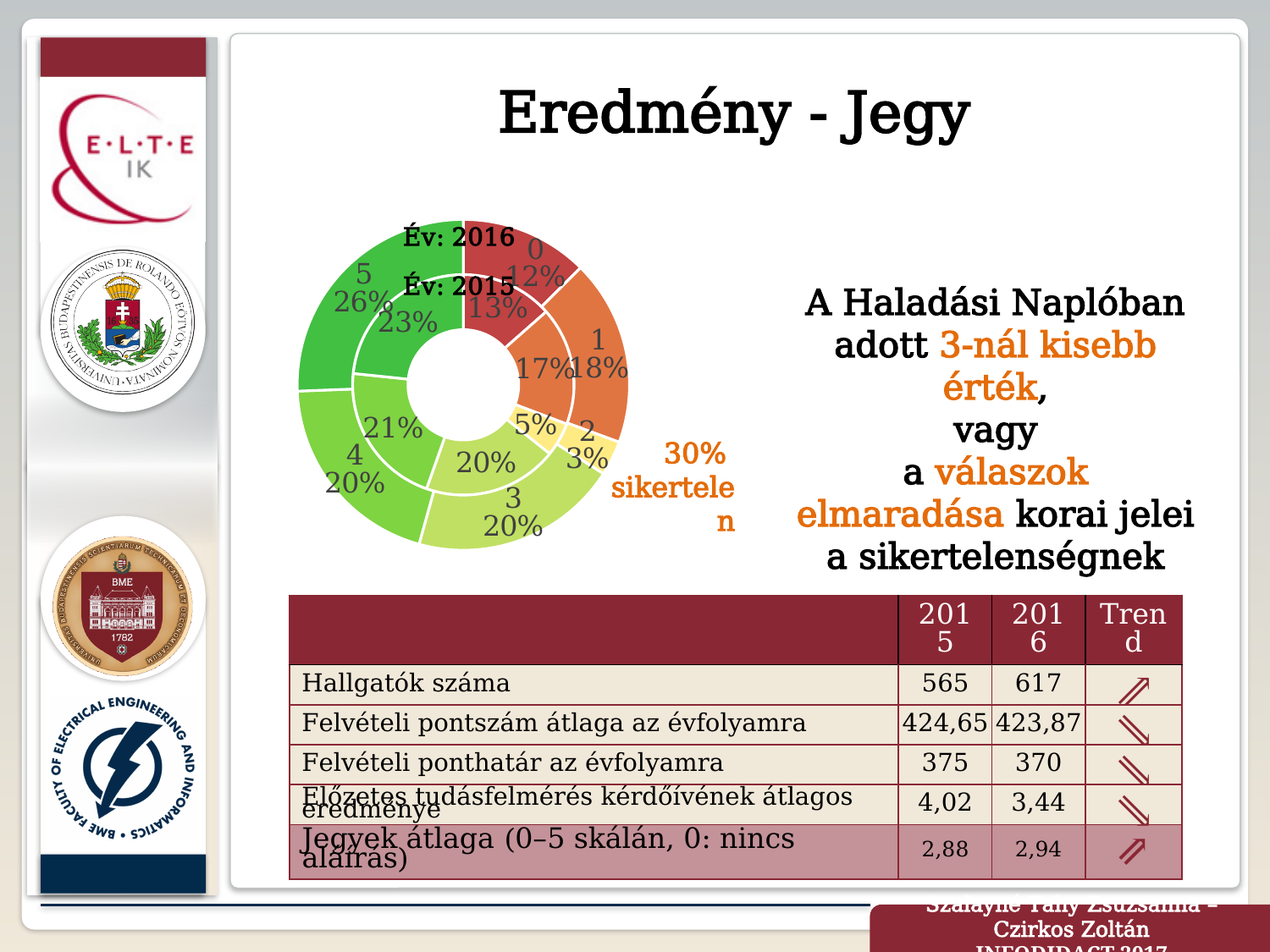
What percentage is highlighted in orange next to the doughnut chart as 'sikertelen'? 30% How many grade categories are shown in the doughnut chart? 6 In the outer ring (Év: 2016) of the doughnut chart, what share is shown for grade 5? 26% What kind of chart is shown on the slide? doughnut chart In the outer ring (Év: 2016) of the doughnut chart, what share is shown for grade 0? 12% How many data series (rings) does the doughnut chart show? 2 Which grade has the smallest share in the outer ring (Év: 2016) of the doughnut chart? 2 Which grade has the smallest share in the inner ring (Év: 2015) of the doughnut chart? 2 Which grade has the largest share in the outer ring (Év: 2016) of the doughnut chart? 5 In the inner ring (Év: 2015) of the doughnut chart, what share is shown for grade 2? 5% In the doughnut chart, is the share of grade 1 larger in the outer ring (Év: 2016) or the inner ring (Év: 2015)? outer ring (Év: 2016) In the doughnut chart, how many percentage points higher is the share of grade 5 in the outer ring (26%) than in the inner ring (23%)? 3